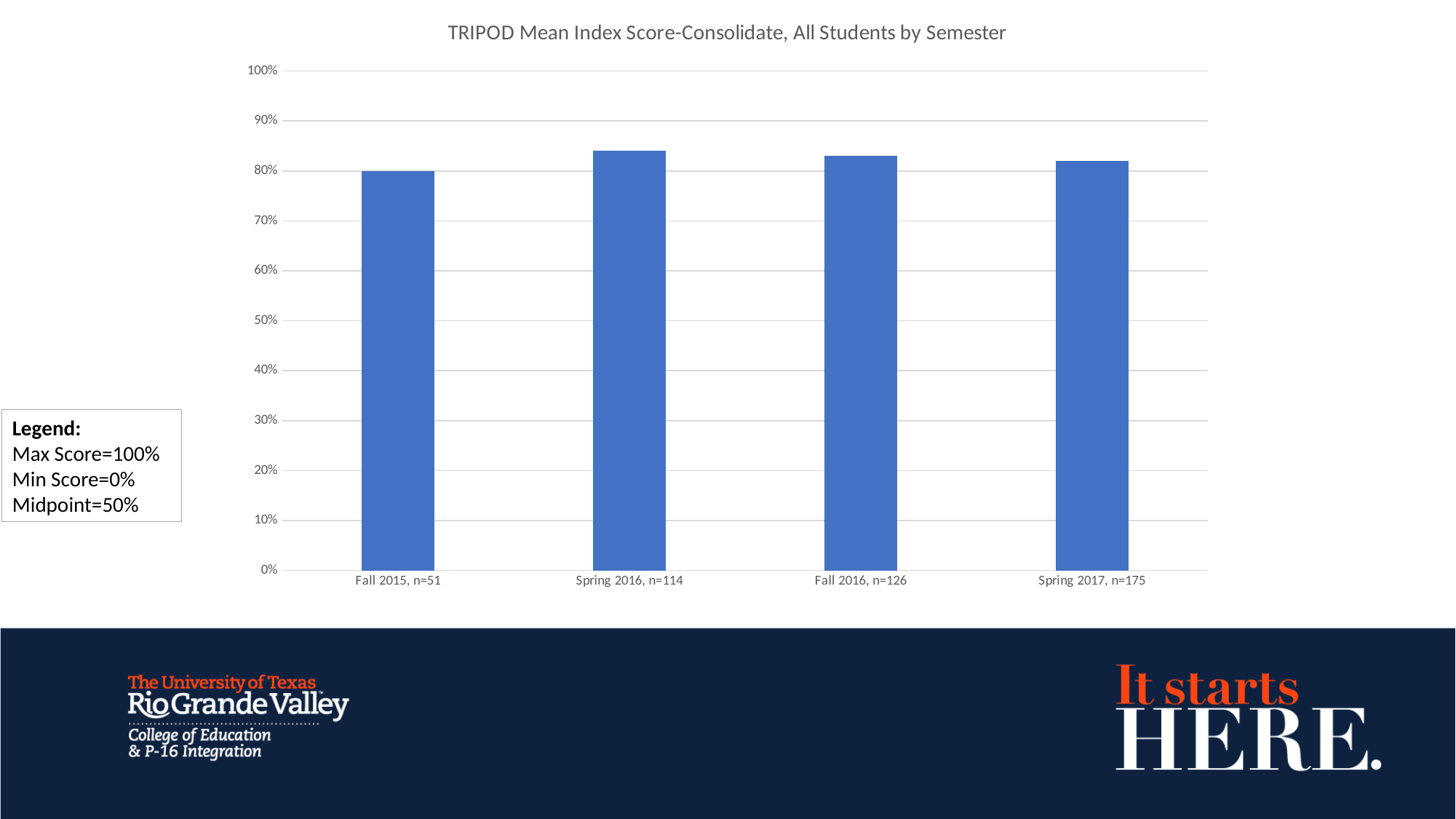
Which is larger, the score for Fall 2015, n=51 or the score for Fall 2016, n=126? Fall 2016, n=126 Is the value for Fall 2016, n=126 greater or less than 50%? greater According to the legend box on the slide, what is the midpoint score? 50% What kind of chart is shown on the slide? bar chart Which semester has the lowest TRIPOD mean index score? Fall 2015, n=51 What is the title of the chart? TRIPOD Mean Index Score-Consolidate, All Students by Semester How many semesters are plotted in the chart? 4 Is the value for Spring 2016, n=114 greater or less than 80%? greater Which is larger, the score for Spring 2016, n=114 or the score for Spring 2017, n=175? Spring 2016, n=114 What is the TRIPOD mean index score for Fall 2015, n=51? 80% Is the value for Spring 2017, n=175 greater or less than 90%? less Which semester has the highest TRIPOD mean index score? Spring 2016, n=114